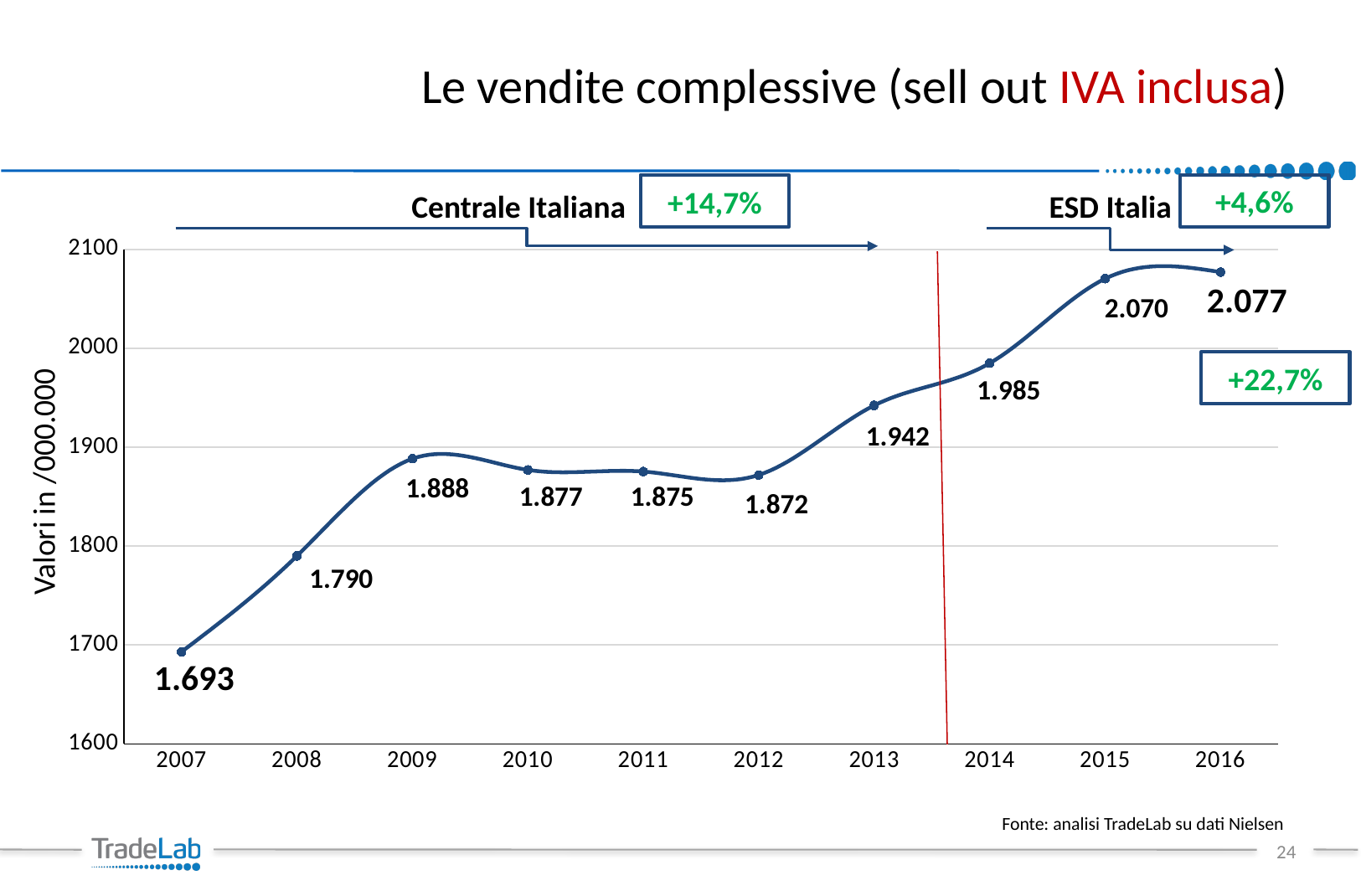
Do the values generally rise or fall from 2012 to 2016? rise What is the difference between the 2016 value and the 2007 value? 384 What kind of chart is shown? line chart What is the difference between the 2015 value and the 2014 value? 85 Which is larger, the value for 2009 or the value for 2012? 2009 Which year has the highest value? 2016 Which year has the lowest value? 2007 What is the value for 2007? 1.693 What is the value for 2015? 2.070 How many years are plotted on the x axis? 10 What is the label on the y axis? Valori in /000.000 What is the value for 2013? 1.942